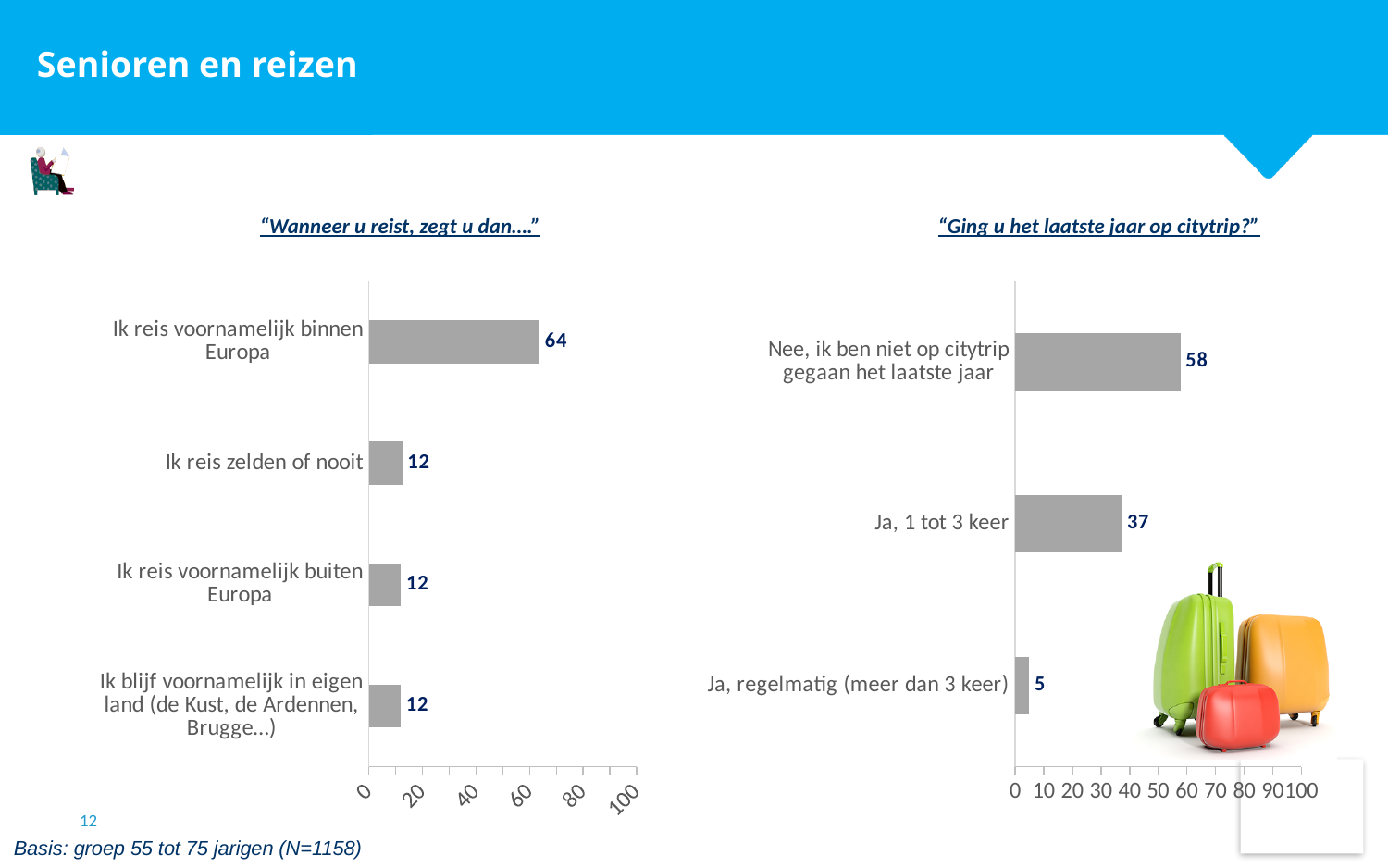
In the chart titled "Ging u het laatste jaar op citytrip?", what is the difference between "Nee, ik ben niet op citytrip gegaan het laatste jaar" and "Ja, 1 tot 3 keer"? 21 What type of chart is the chart titled "Wanneer u reist, zegt u dan...."? Bar chart In the chart titled "Ging u het laatste jaar op citytrip?", which category has the lowest value? Ja, regelmatig (meer dan 3 keer) In the chart titled "Ging u het laatste jaar op citytrip?", which is larger: "Nee, ik ben niet op citytrip gegaan het laatste jaar" or "Ja, 1 tot 3 keer"? Nee, ik ben niet op citytrip gegaan het laatste jaar In the chart titled "Wanneer u reist, zegt u dan....", how many categories are shown? 4 In the chart titled "Ging u het laatste jaar op citytrip?", what is the value for "Ja, regelmatig (meer dan 3 keer)"? 5 In the chart titled "Ging u het laatste jaar op citytrip?", how many categories are shown? 3 In the chart titled "Ging u het laatste jaar op citytrip?", what is the value for "Ja, 1 tot 3 keer"? 37 In the chart titled "Wanneer u reist, zegt u dan....", what is the difference between "Ik reis voornamelijk binnen Europa" and "Ik reis voornamelijk buiten Europa"? 52 In the chart titled "Wanneer u reist, zegt u dan....", which category has the highest value? Ik reis voornamelijk binnen Europa In the chart titled "Wanneer u reist, zegt u dan....", what is the value for "Ik reis voornamelijk binnen Europa"? 64 In the chart titled "Wanneer u reist, zegt u dan....", what is the value for "Ik reis zelden of nooit"? 12